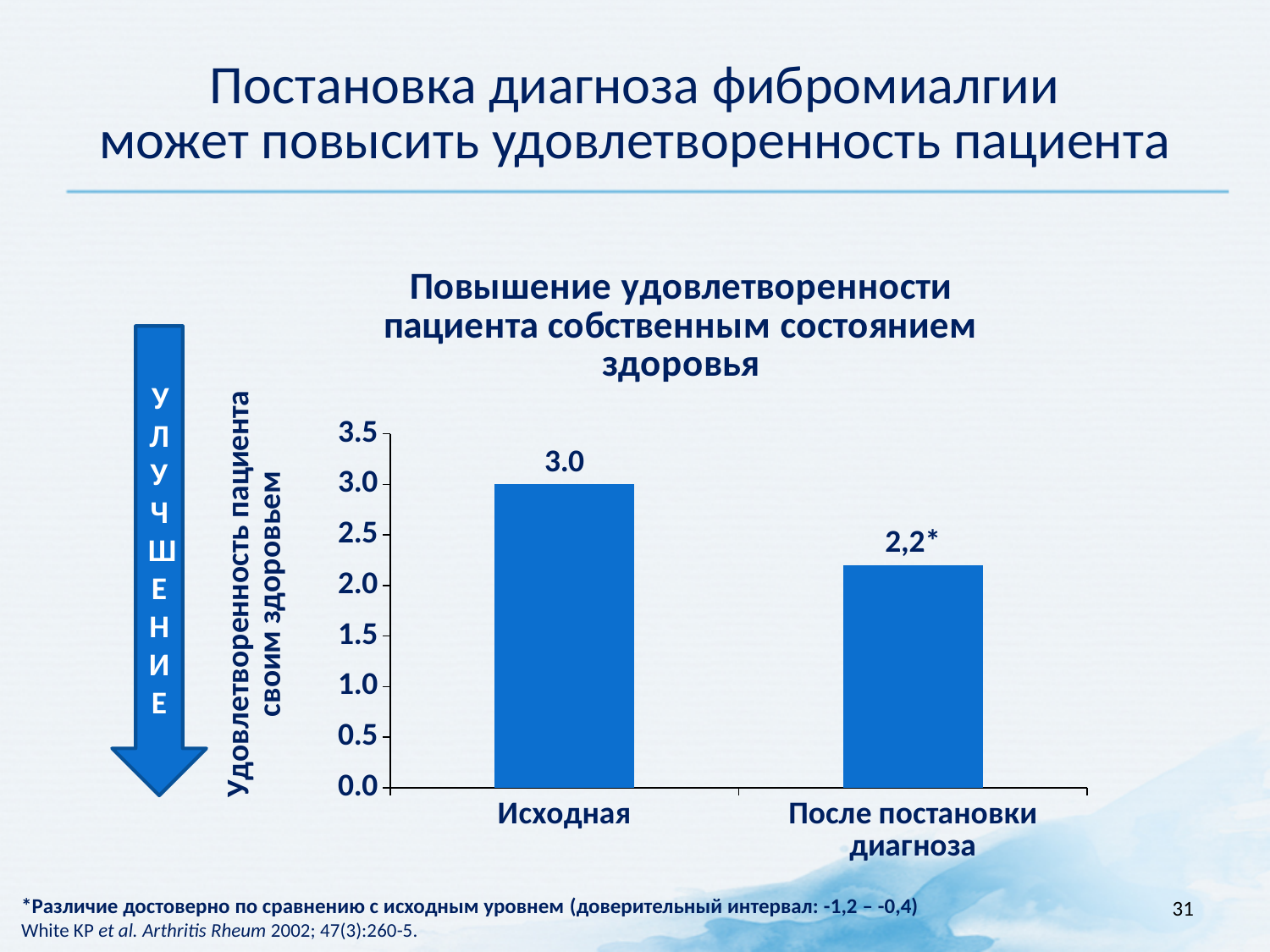
Do the values rise or fall from "Исходная" to "После постановки диагноза"? fall What is the value for the "После постановки диагноза" bar? 2,2 Which is larger, the value for "Исходная" or the value for "После постановки диагноза"? Исходная What is the value for the "Исходная" bar? 3.0 How many categories are shown on the x axis? 2 Which category has the lowest value? После постановки диагноза What is the label of the vertical axis? Удовлетворенность пациента своим здоровьем Is the value for "После постановки диагноза" greater or less than 2.5? less What kind of chart is shown on the slide? bar chart What is the difference between the "Исходная" value and the "После постановки диагноза" value? 0.8 What is the title of the chart? Повышение удовлетворенности пациента собственным состоянием здоровья Which category has the highest value? Исходная